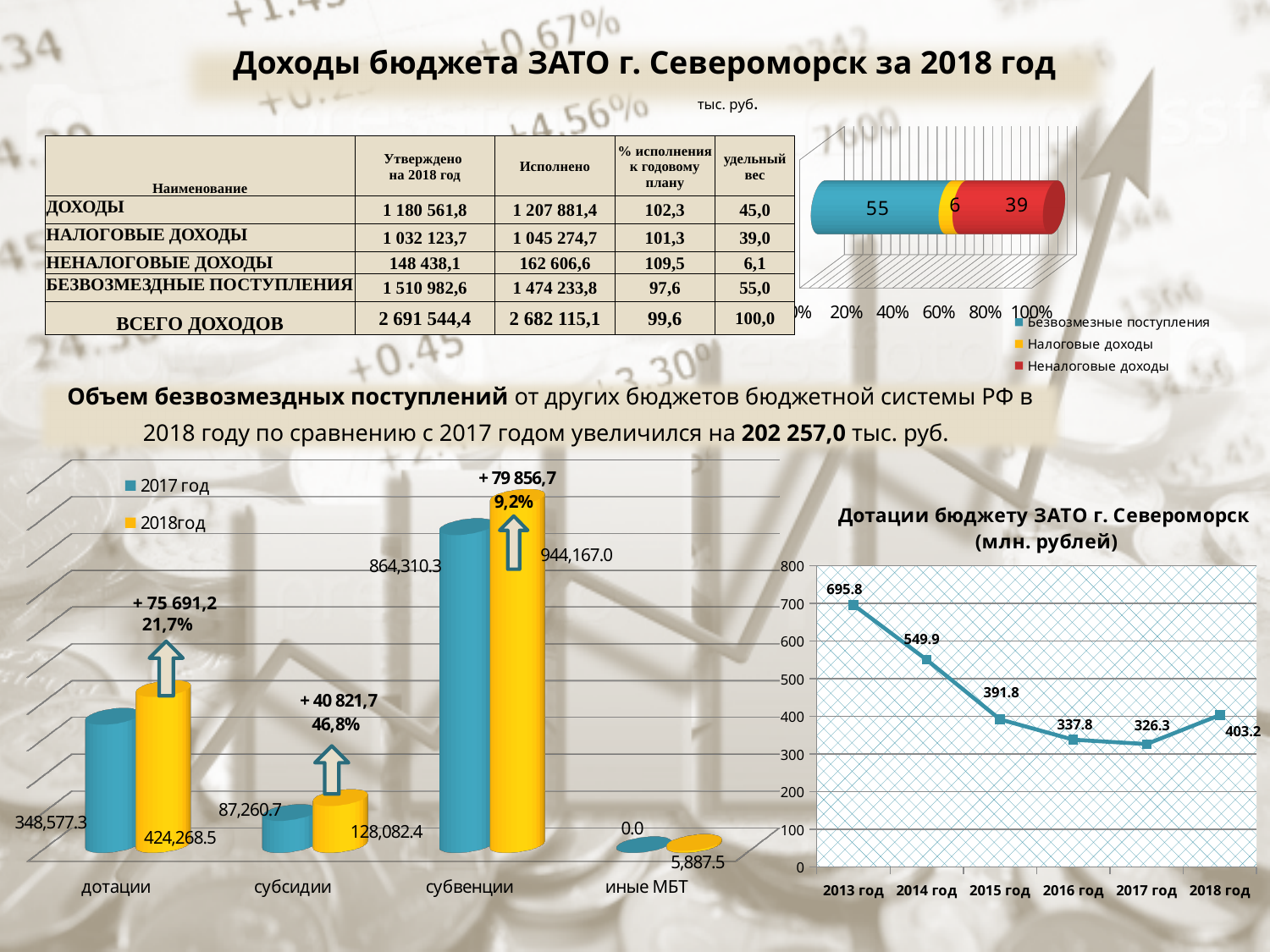
On the stacked bar chart at the top right, what is the value for Безвозмездные поступления? 55 On the bar chart at the bottom left comparing 2017 год and 2018год, which category has the highest 2018год value? субвенции On the line chart 'Дотации бюджету ЗАТО г. Североморск (млн. рублей)', what is the difference between the 2013 год and 2014 год values? 145.9 What kind of chart is the chart titled 'Дотации бюджету ЗАТО г. Североморск (млн. рублей)'? line chart On the line chart 'Дотации бюджету ЗАТО г. Североморск (млн. рублей)', what is the value for 2013 год? 695.8 On the bar chart at the bottom left comparing 2017 год and 2018год, what is the 2017 год value for дотации? 348,577.3 On the bar chart at the bottom left comparing 2017 год and 2018год, how many series does the legend list? 2 On the line chart 'Дотации бюджету ЗАТО г. Североморск (млн. рублей)', which year has the lowest value? 2017 год On the line chart 'Дотации бюджету ЗАТО г. Североморск (млн. рублей)', do the values rise or fall from 2013 год to 2017 год? fall On the line chart 'Дотации бюджету ЗАТО г. Североморск (млн. рублей)', how many years are plotted? 6 On the bar chart at the bottom left comparing 2017 год and 2018год, what is the 2018год value for субвенции? 944,167.0 On the line chart 'Дотации бюджету ЗАТО г. Североморск (млн. рублей)', which year has the highest value? 2013 год